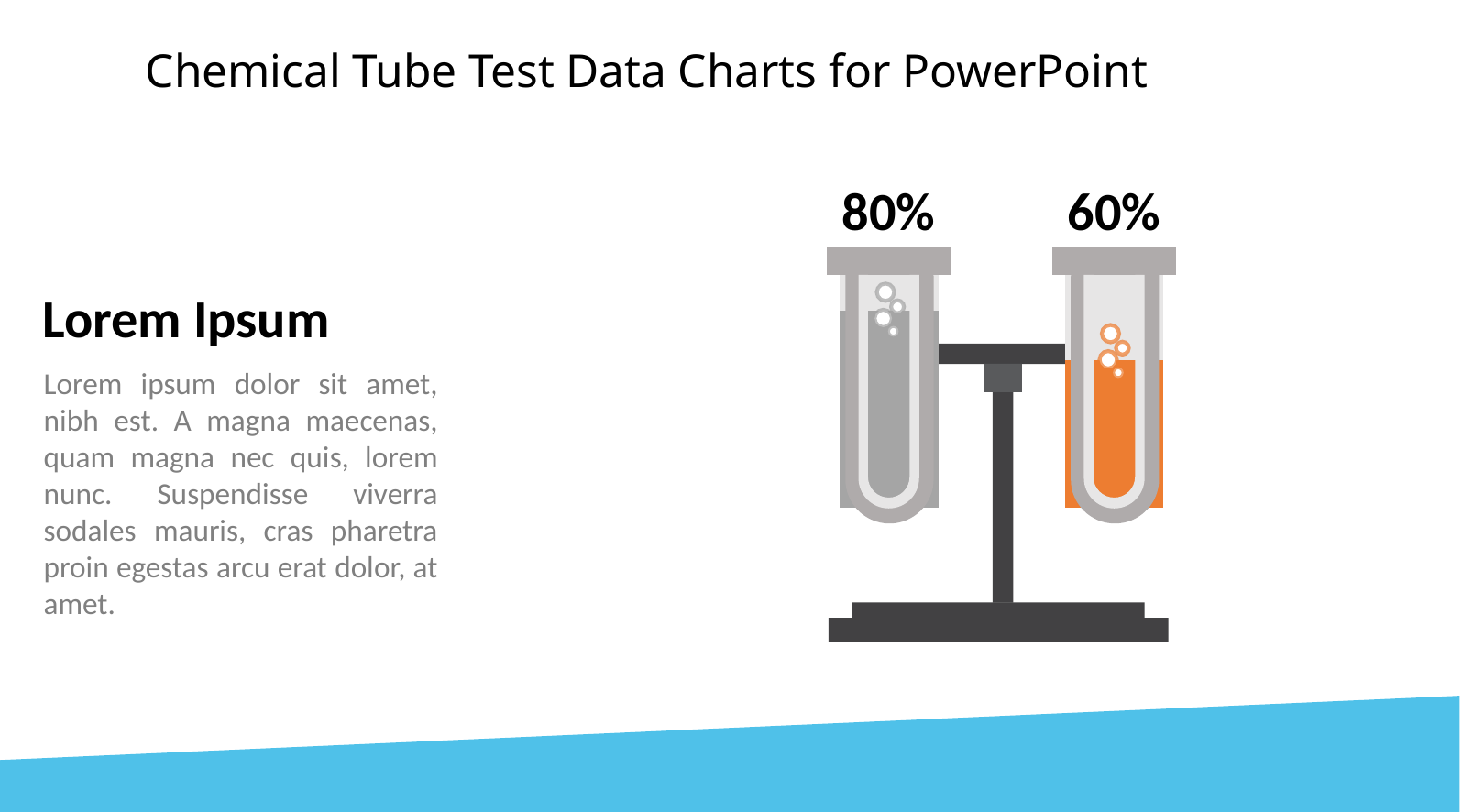
What value is shown for the grey-filled test tube? 80% What colour is the liquid in the test tube labelled 60%? orange Is the value for the left test tube larger than the value for the right test tube? Yes Is the value for the right test tube greater or less than 50%? greater What is the difference between the percentages shown on the two test tubes? 20% What percentage is shown above the left test tube? 80% How many test tubes are shown in the chart? 2 What value is shown for the orange-filled test tube? 60% What is the title of the slide? Chemical Tube Test Data Charts for PowerPoint What percentage is shown above the right test tube? 60% Which test tube shows the higher percentage, the left or the right? left Which test tube shows the lower percentage, the left or the right? right